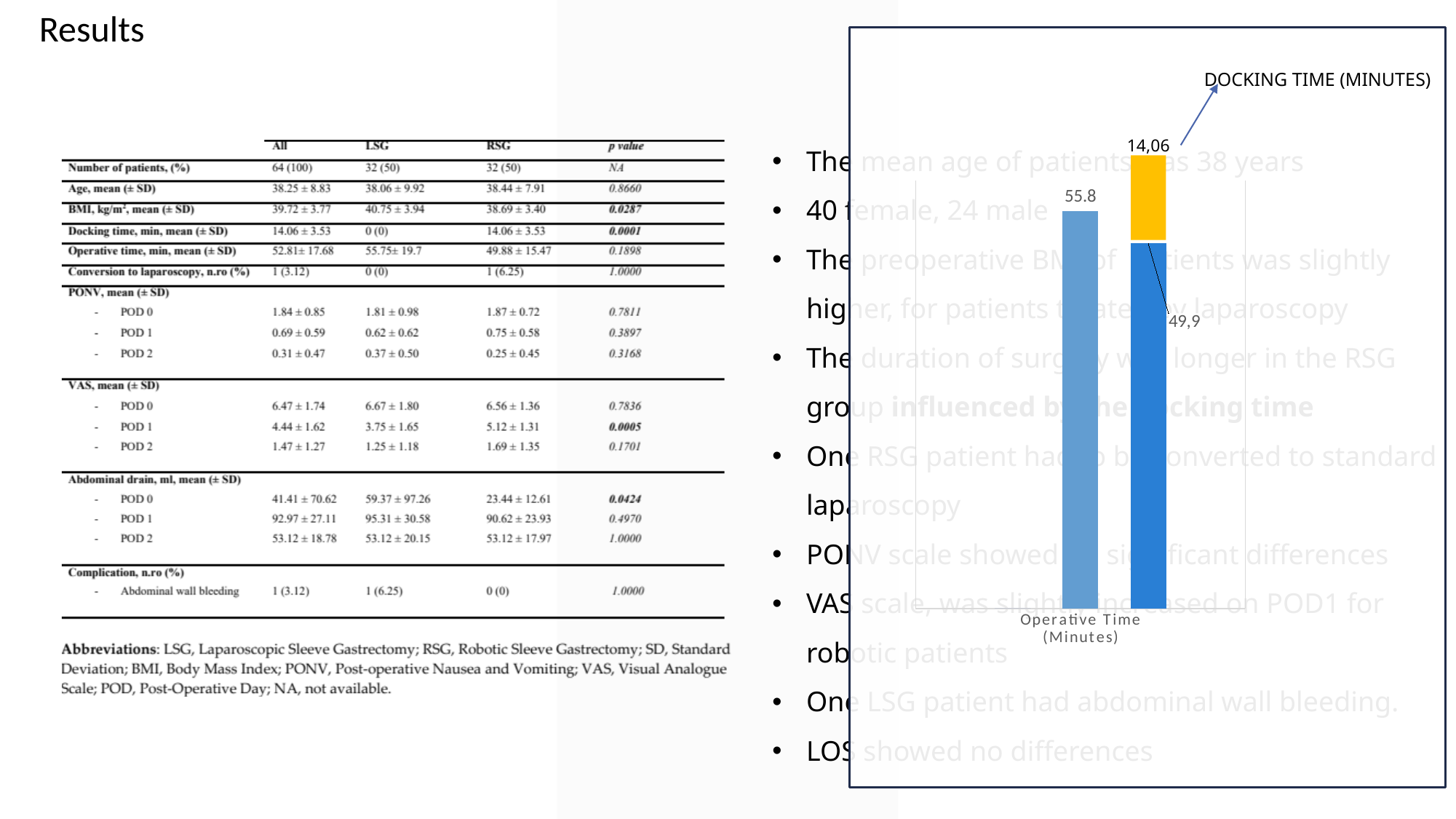
What is the category label shown on the x axis of the chart? Operative Time (Minutes) How many bars are plotted in the chart? 2 What value is printed on the light blue bar in the chart? 55.8 What value is printed on the dark blue segment of the stacked bar? 49,9 What is the total of the stacked bar (dark blue 49,9 plus orange 14,06)? 63,96 Which is larger: the light blue bar (55.8) or the dark blue segment (49,9)? the light blue bar (55.8) What is the difference between the light blue bar value (55.8) and the dark blue segment value (49,9)? 5.9 What kind of chart is shown on the right side of the slide? bar chart What value is printed on the orange segment of the stacked bar? 14,06 What does the orange segment of the stacked bar represent, according to the annotation? Docking time (minutes)